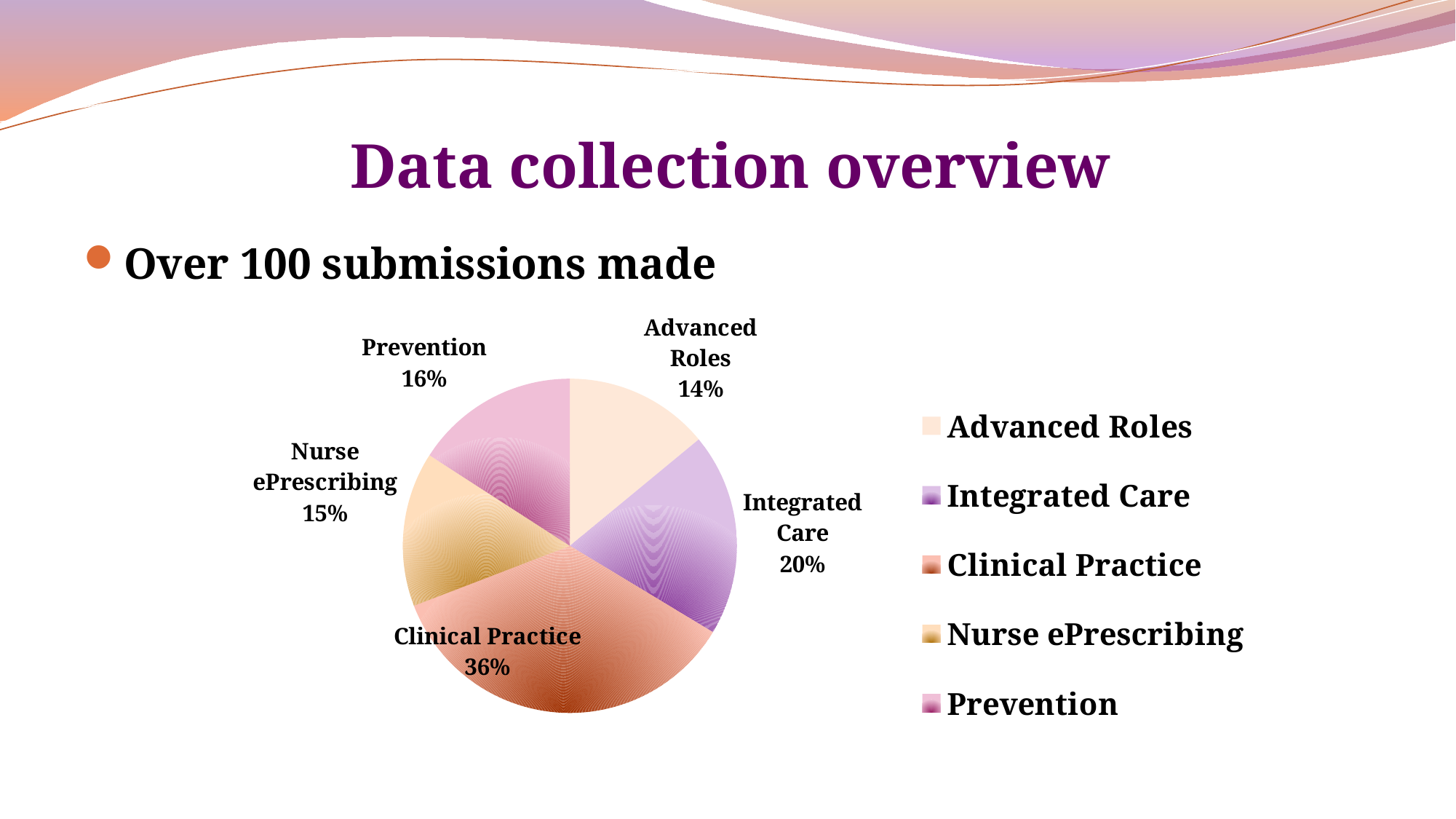
Which category has the largest slice of the pie? Clinical Practice What is the value shown for Nurse ePrescribing? 15% Which category has the smallest slice of the pie? Advanced Roles Which legend entry is listed last? Prevention What is the value shown for Prevention? 16% How many categories are shown in the pie chart? 5 What is the value shown for Integrated Care? 20% Which is larger, the share for Prevention or the share for Advanced Roles? Prevention What is the difference in percentage points between Clinical Practice and Integrated Care? 16 What is the value shown for Advanced Roles? 14% What share of the pie does Clinical Practice represent? 36% What kind of chart is shown on the slide? Pie chart